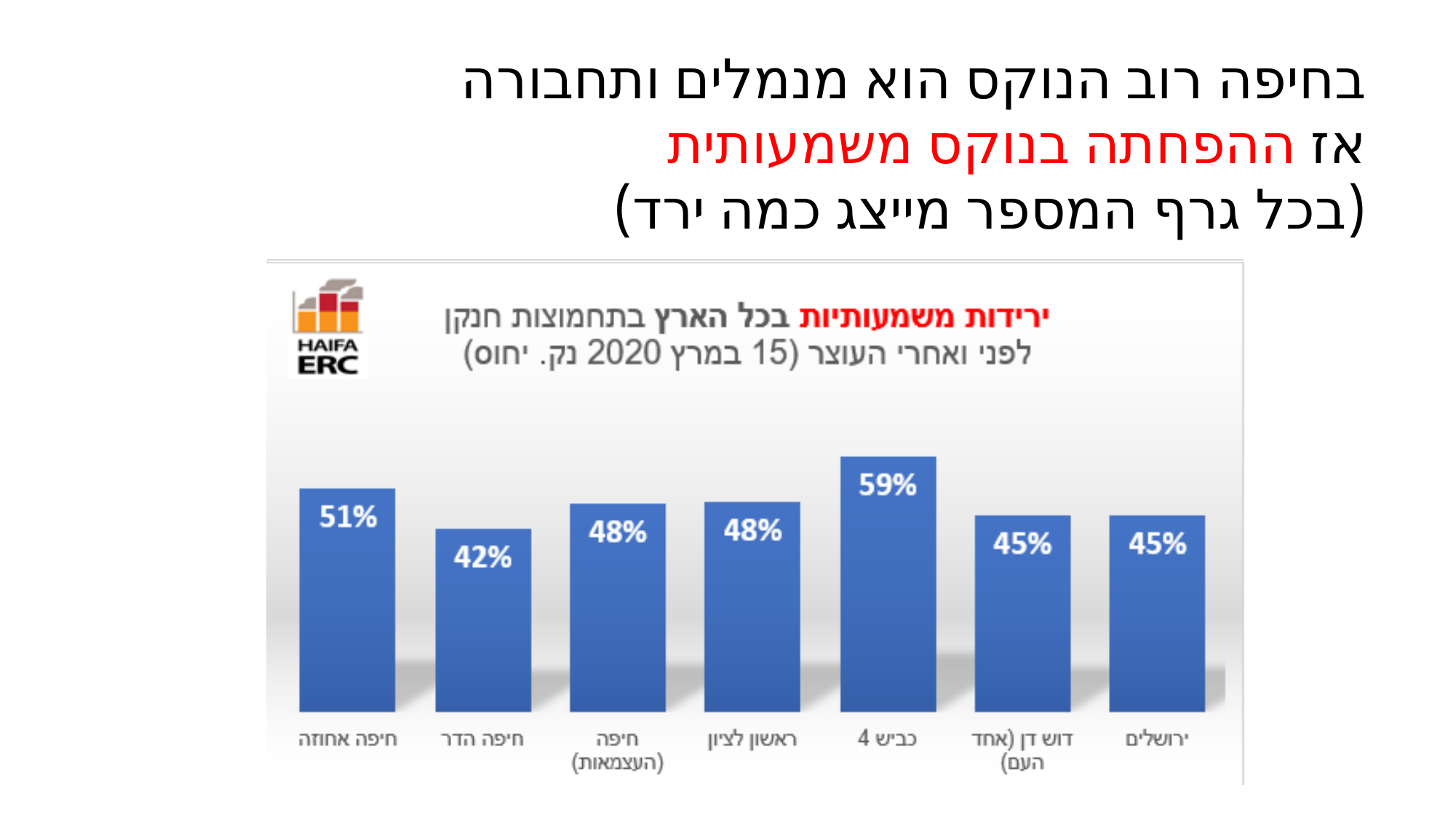
How many categories are shown in the chart? 7 Which category has the lowest value? חיפה הדר What is the value shown for ירושלים? 45% What is the value shown for חיפה אחוזה? 51% What is the value shown for חיפה הדר? 42% What colour are the bars in the chart? Blue What is the value shown for כביש 4? 59% Which category has the highest value? כביש 4 What kind of chart is shown on the slide? Bar chart What is the difference between the values for חיפה אחוזה and ירושלים? 6% Which is larger, the value for חיפה אחוזה or the value for ראשון לציון? חיפה אחוזה What is the difference between the values for כביש 4 and חיפה הדר? 17%